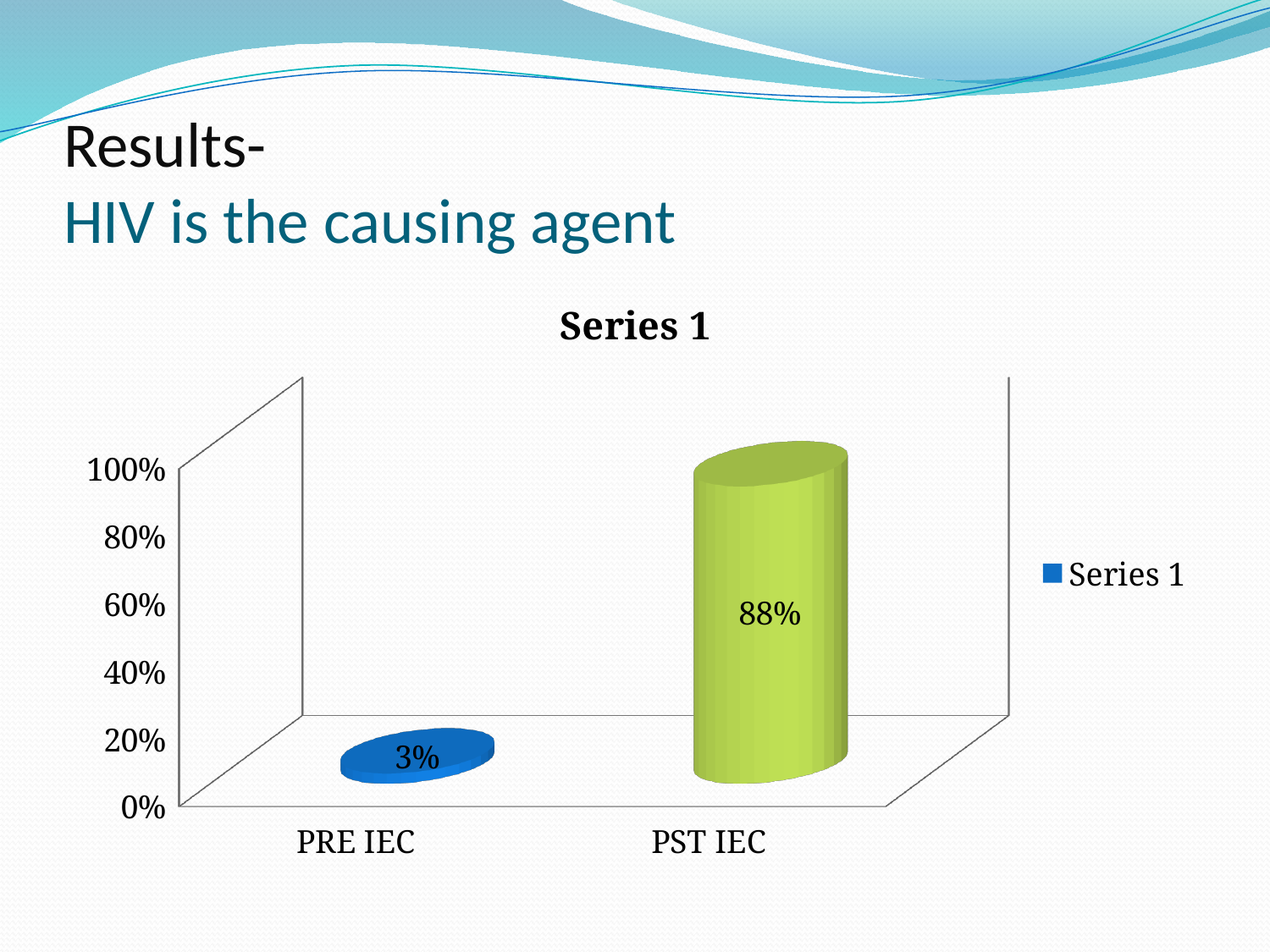
Is the value for PST IEC greater or less than 80%? greater What is the title of the chart? Series 1 Which is larger, the value for PRE IEC or the value for PST IEC? PST IEC How many categories are shown on the x axis? 2 What is the value for PST IEC? 88% Which category has the highest value? PST IEC What is the value for PRE IEC? 3% Is the value for PRE IEC greater or less than 20%? less Which category has the lowest value? PRE IEC What kind of chart is shown on the slide? Bar chart How many series does the legend list? 1 What is the difference between the PST IEC and PRE IEC values? 85%